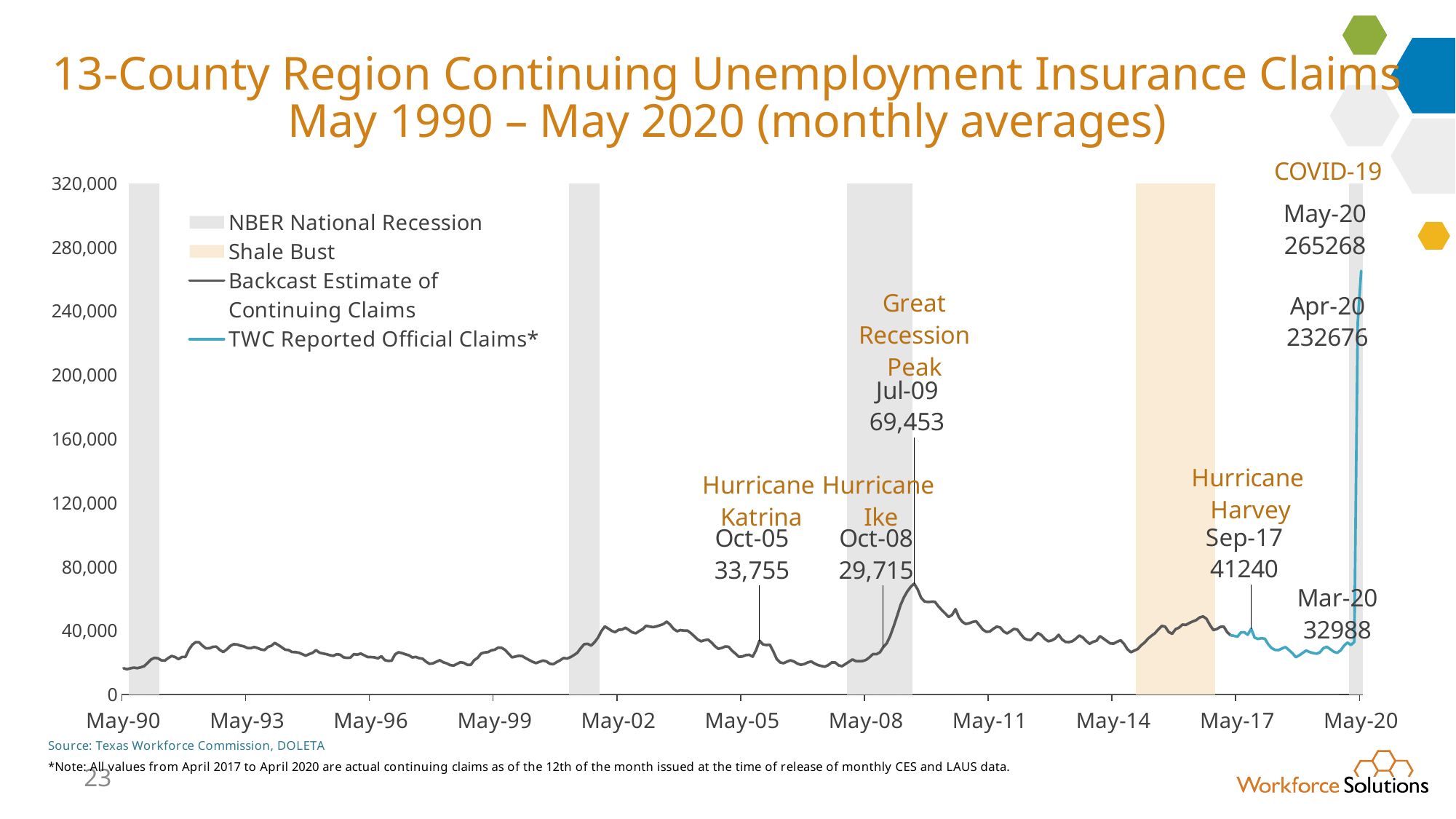
What type of chart is shown on the slide? line chart Is the value at May-90 greater or less than 40,000? less What value is labeled for Hurricane Katrina in Oct-05? 33,755 What was the value of continuing claims in May-20 (COVID-19 annotation)? 265268 Which labeled point has the lowest value: Oct-05, Oct-08 or Sep-17? Oct-08 What is the difference between the May-20 value and the Apr-20 value? 32592 How many entries does the legend list? 4 Which is larger, the Jul-09 value or the Sep-17 value? Jul-09 Which labeled point has the highest value on the chart? May-20 What value is labeled for Apr-20? 232676 What value is labeled for Hurricane Harvey in Sep-17? 41240 What value is labeled for the Great Recession Peak in Jul-09? 69,453